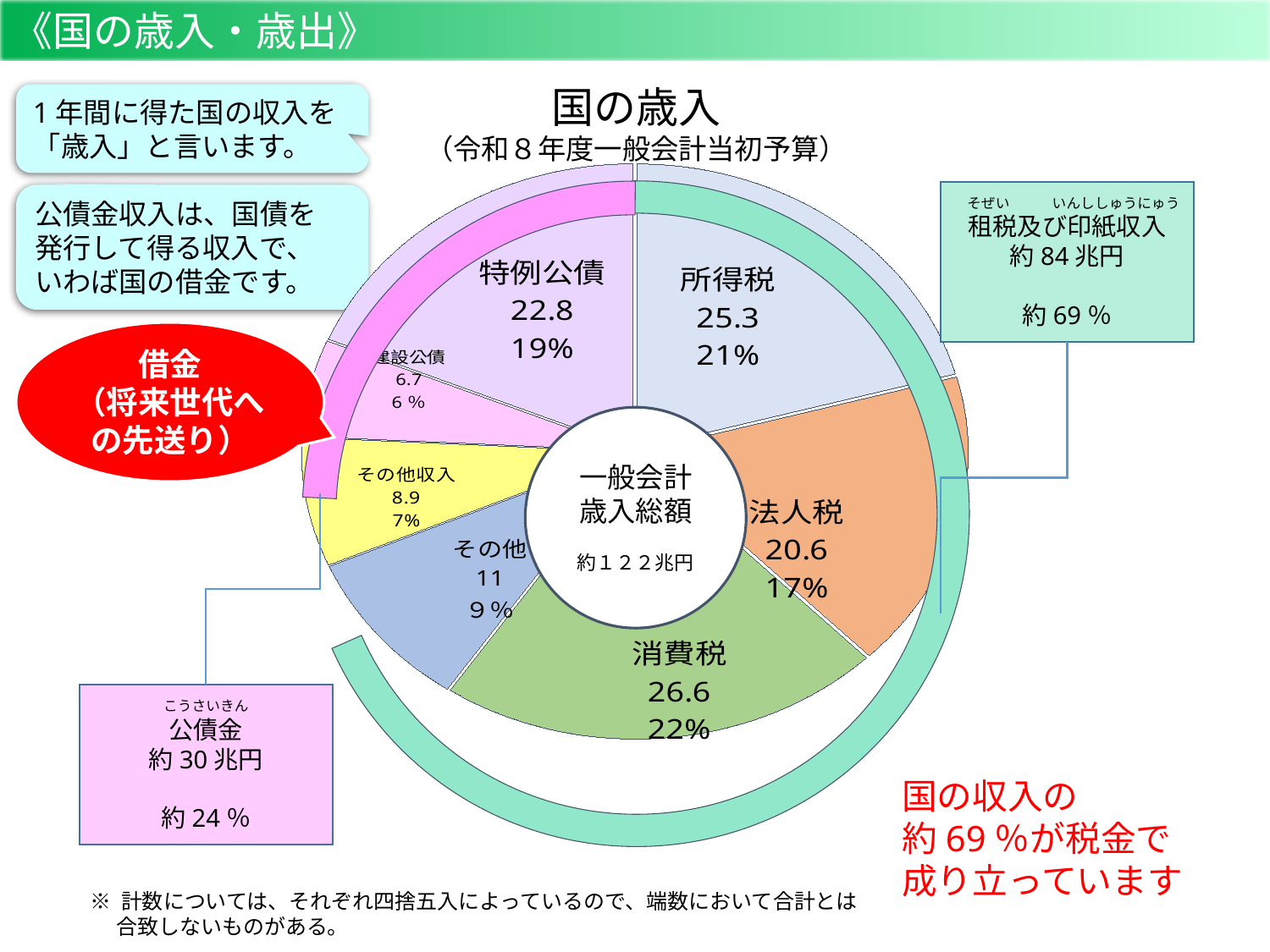
How many slices does the pie chart have? 7 What is the value shown for 所得税? 25.3 What kind of chart is shown on the slide? Pie chart What is the value shown for 法人税? 20.6 Which slice has the largest value? 消費税 What is the difference between the values for 所得税 and 法人税? 4.7 Which is larger, the value for 特例公債 or the value for 法人税? 特例公債 What is the value shown for 特例公債? 22.8 Which slice has the smallest value? 建設公債 What percentage share does その他収入 have in the pie? 7% What percentage share does 消費税 have in the pie? 22% What is the title of the chart? 国の歳入